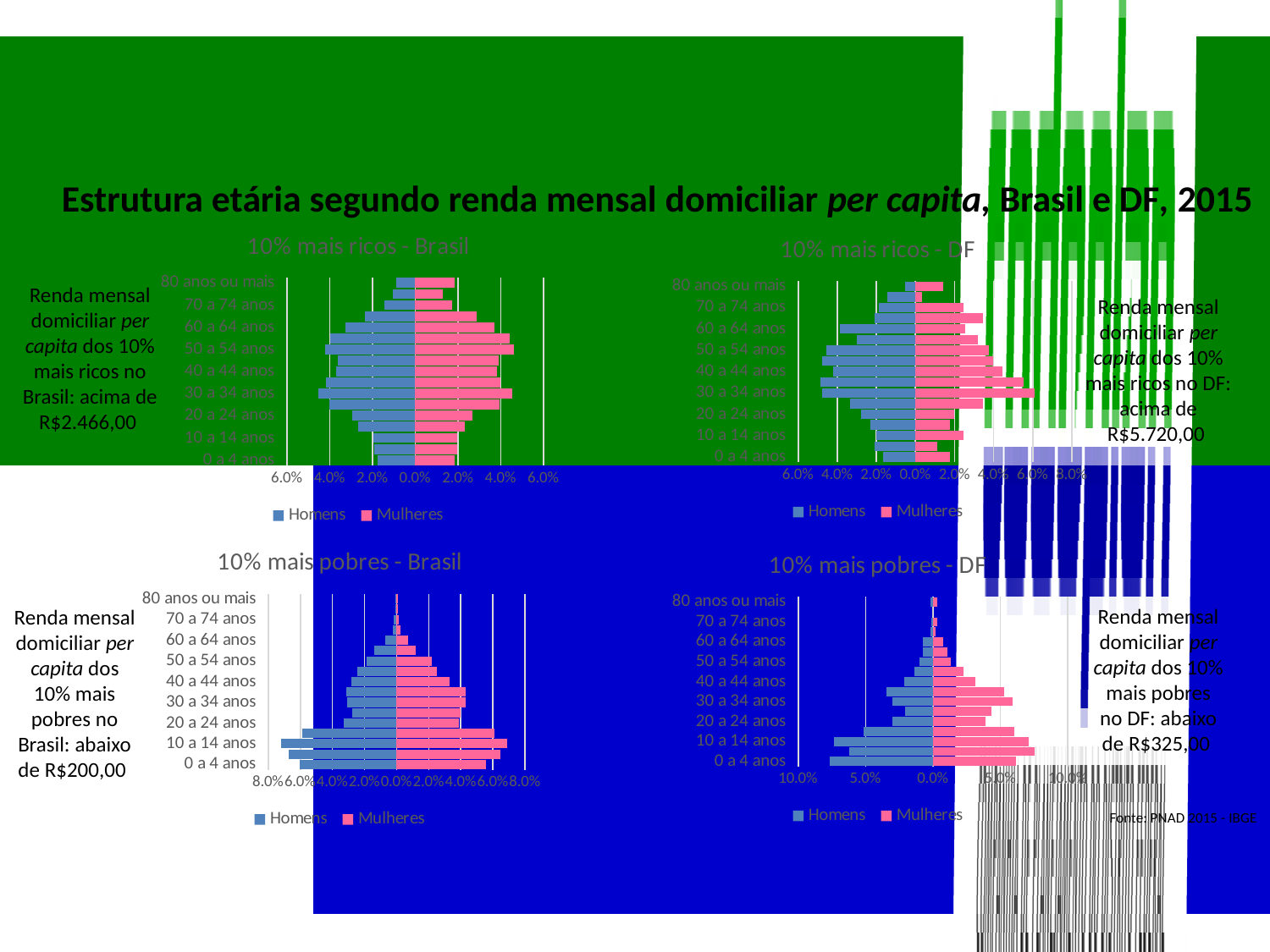
In "10% mais pobres - Brasil", is the Mulheres value for 0 a 4 anos greater or less than 4.0%? greater How many series does the legend of "10% mais ricos - DF" list? 2 What kind of chart is "10% mais pobres - Brasil"? bar chart What is the title of the chart in the top-left of the slide? 10% mais ricos - Brasil In "10% mais pobres - DF", is the Homens value for 80 anos ou mais greater or less than 5.0%? less In "10% mais pobres - Brasil", which series is shown in pink? Mulheres In "10% mais ricos - Brasil", is the Mulheres value for 50 a 54 anos greater or less than 4.0%? greater In "10% mais pobres - DF", which is larger for Mulheres: 0 a 4 anos or 80 anos ou mais? 0 a 4 anos